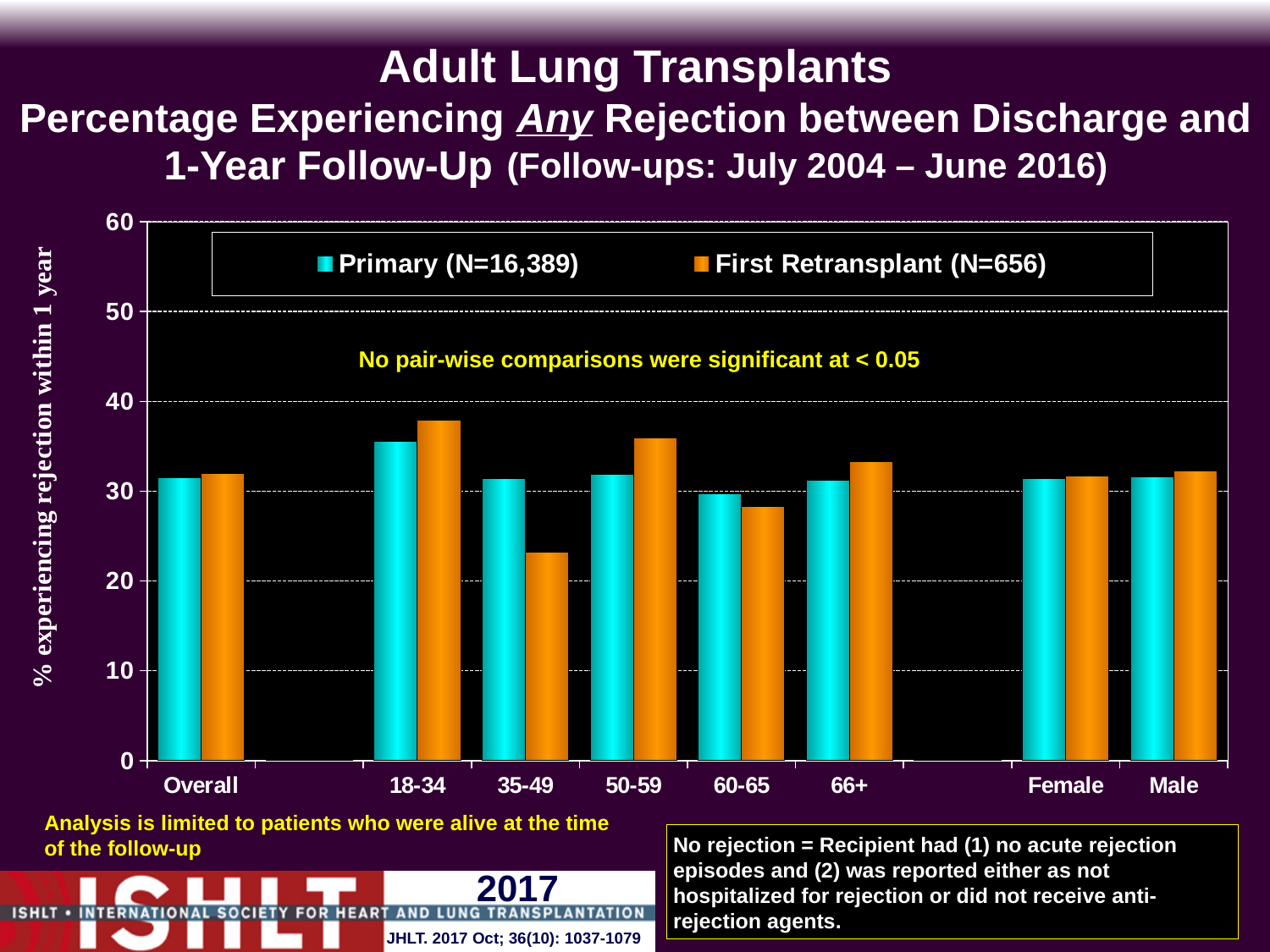
Is the First Retransplant value for 18-34 greater or less than 30? greater Which category has the lowest value for First Retransplant (N=656)? 35-49 What is the sample size (N) given in the legend for the Primary series? 16,389 Which category has the highest value for Primary (N=16,389)? 18-34 What kind of chart is shown on the slide? bar chart For the 35-49 age group, which series has the larger value, Primary or First Retransplant? Primary For the 50-59 age group, which series has the larger value, Primary or First Retransplant? First Retransplant Is the Primary value for 18-34 greater or less than 30? greater Is the First Retransplant value for 35-49 greater or less than 30? less How many categories are shown along the x axis? 8 Which category has the highest value for First Retransplant (N=656)? 18-34 How many series does the legend list? 2